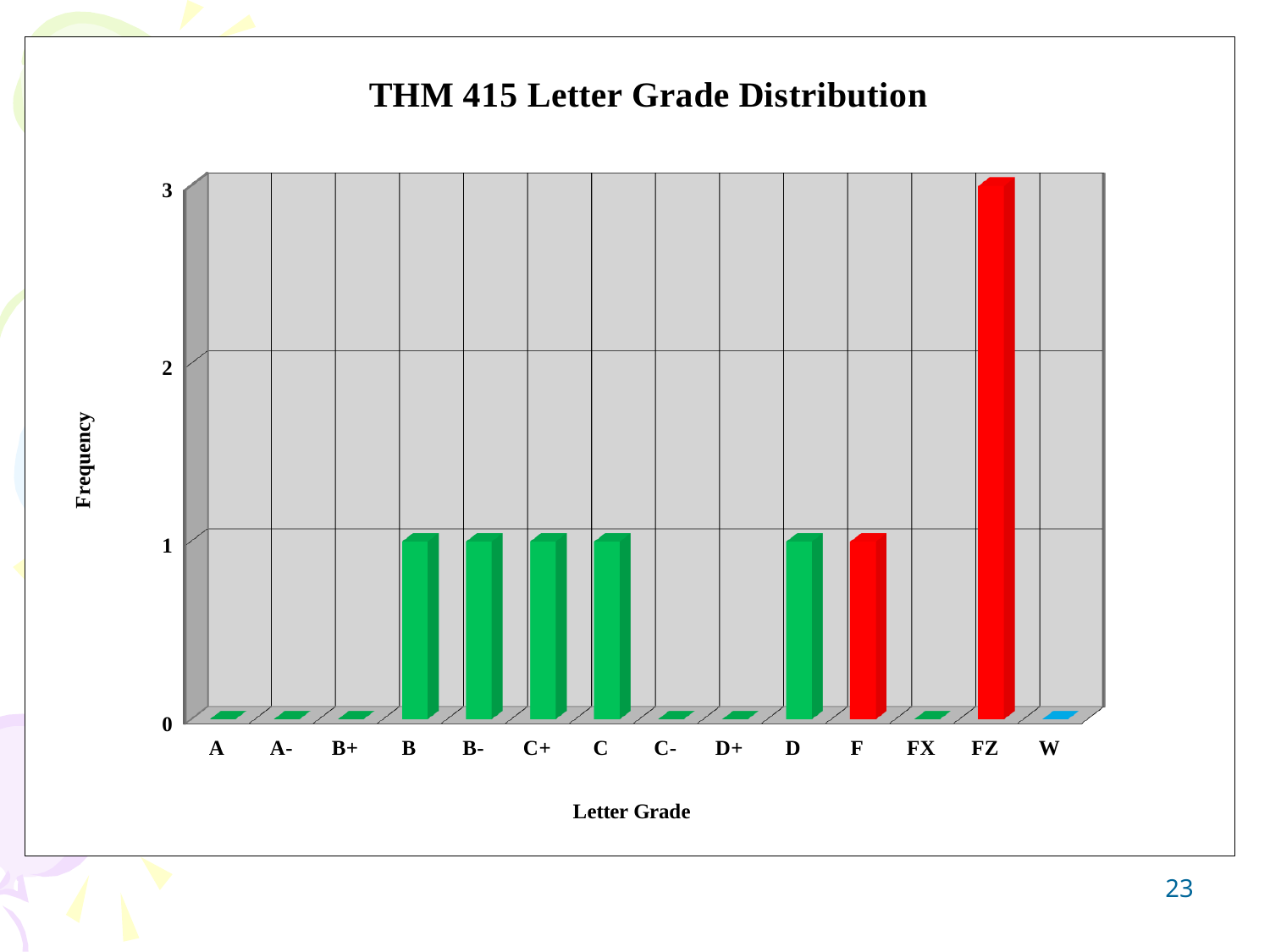
What is the label of the y axis? Frequency What is the frequency for the F grade? 1 What is the frequency for the FZ grade? 3 What kind of chart is shown on the slide? bar chart What is the title of the chart? THM 415 Letter Grade Distribution Which has a higher frequency, D or D+? D How many letter grade categories are shown on the x axis? 14 Which letter grade has the highest frequency? FZ What is the difference in frequency between FZ and F? 2 What is the frequency for the B grade? 1 What is the frequency for the A grade? 0 Is the frequency for FZ greater or less than 2? greater